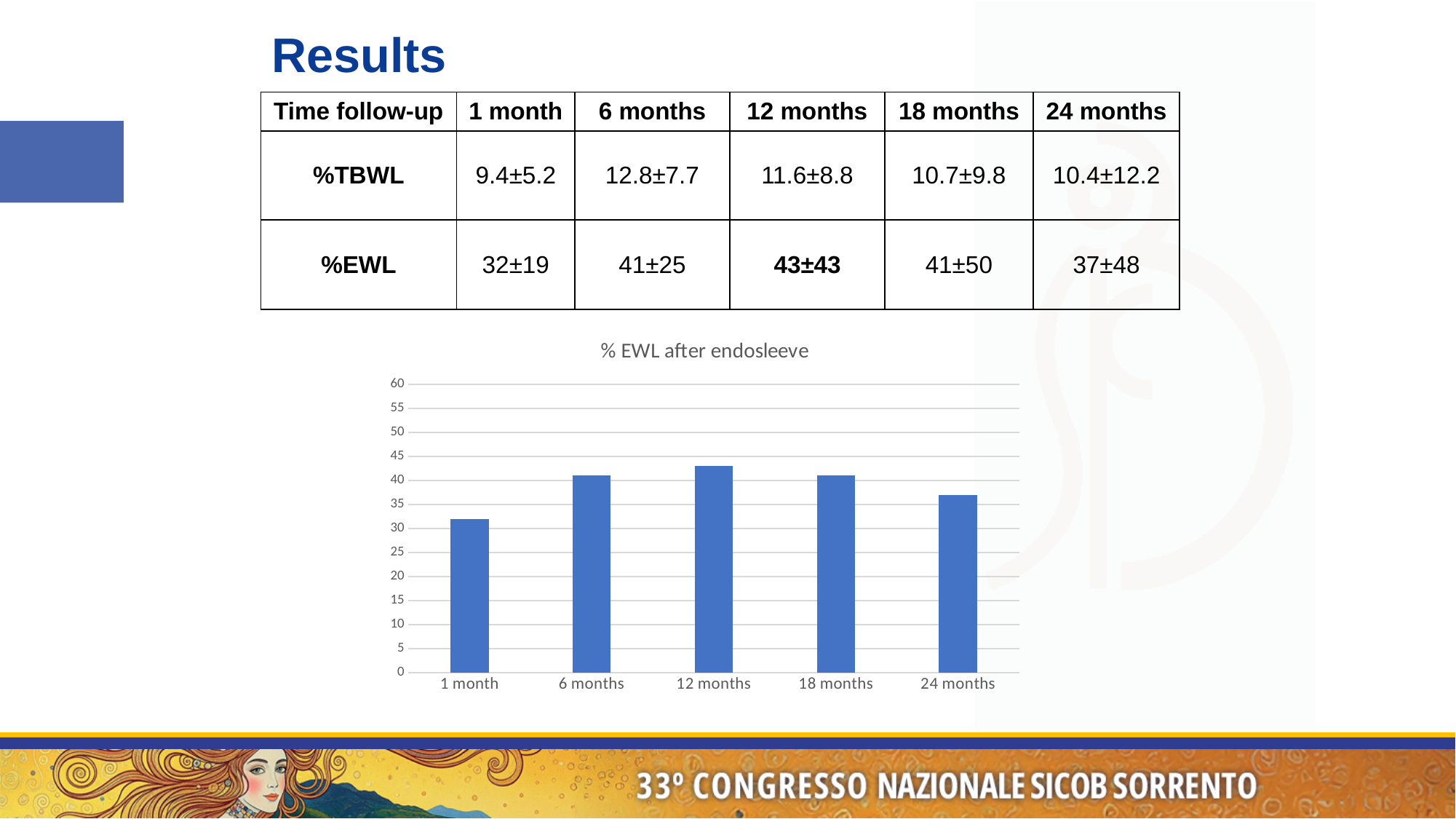
Is the % EWL value for 12 months greater or less than 40? greater Which follow-up time point has the lowest % EWL in the chart? 1 month What is the % EWL value plotted for 24 months? 37 Which follow-up time point has the highest % EWL in the chart? 12 months What is the title of the chart? % EWL after endosleeve What is the % EWL value plotted for 1 month? 32 What is the difference between the % EWL at 12 months and at 1 month? 11 What type of chart is shown on the slide? bar chart What is the % EWL value plotted for 12 months? 43 Is the % EWL value for 1 month greater or less than 35? less How many follow-up time points are plotted in the chart? 5 Which has a larger % EWL in the chart, 12 months or 24 months? 12 months